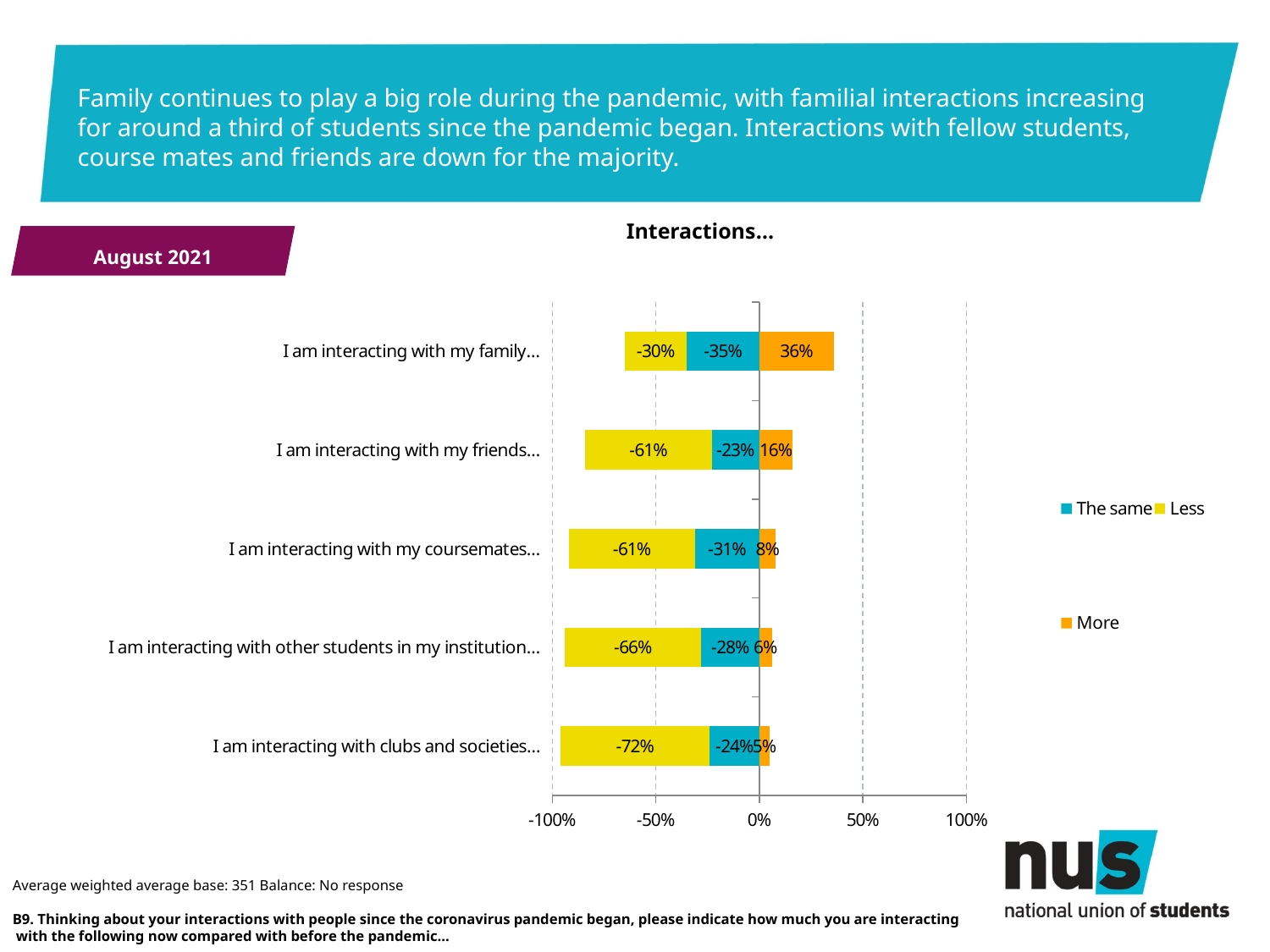
Which category has the highest 'More' value? I am interacting with my family... What is the title of the chart? Interactions... What is the 'More' value for 'I am interacting with other students in my institution...'? 6% How many categories are shown on the chart? 5 Which is larger in magnitude: the 'Less' value for 'I am interacting with my friends...' or for 'I am interacting with other students in my institution...'? I am interacting with other students in my institution... What is the 'Less' value for 'I am interacting with clubs and societies...'? -72% Which category has the lowest 'More' value? I am interacting with clubs and societies... How many series does the legend list? 3 What is the 'The same' value for 'I am interacting with my coursemates...'? -31% What kind of chart is shown on the slide? Stacked bar chart What is the difference between the 'More' values for 'I am interacting with my family...' and 'I am interacting with my friends...'? 20 percentage points What is the 'More' value for 'I am interacting with my family...'? 36%